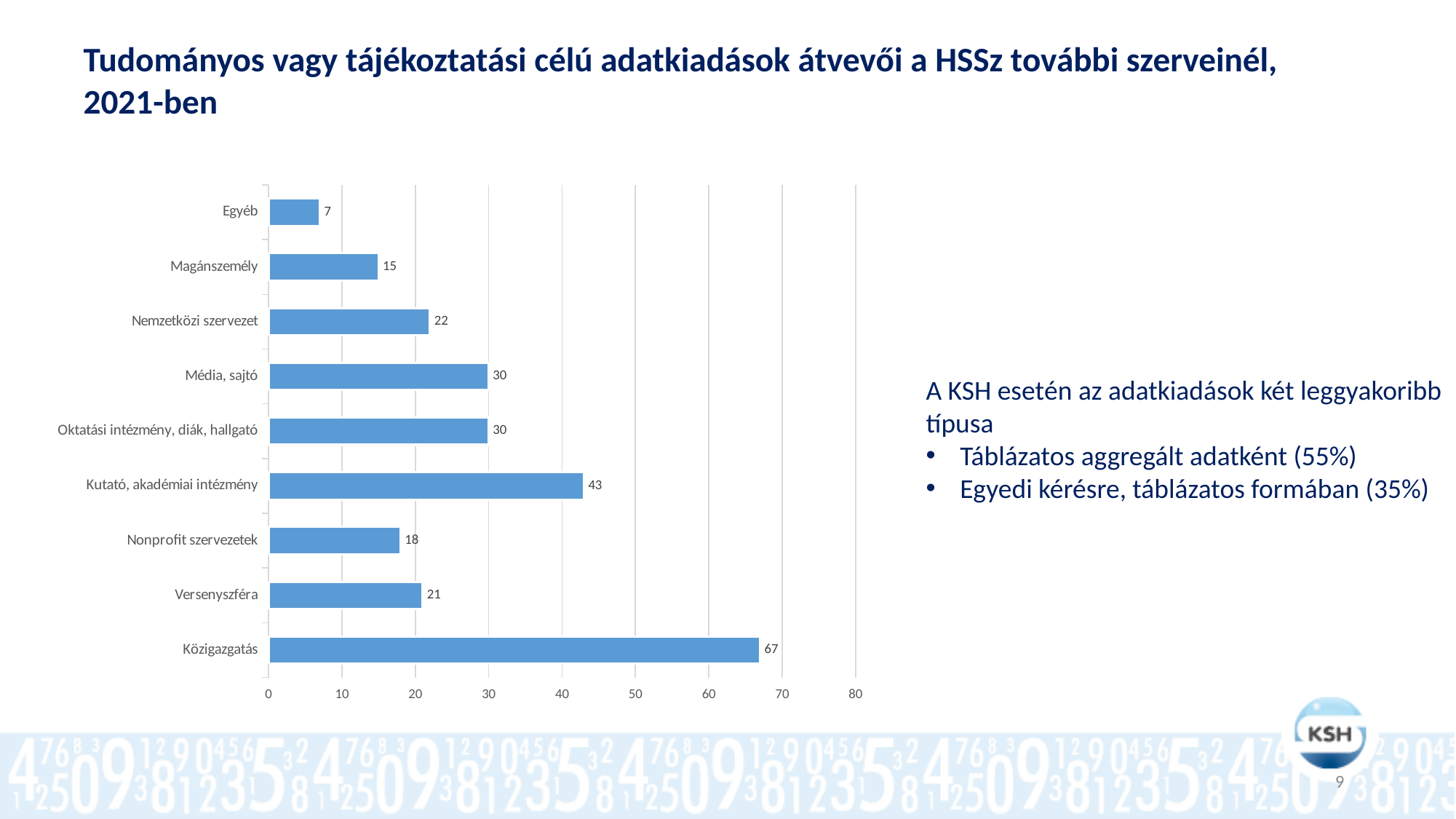
Which category has the lowest value? Egyéb What kind of chart is shown on the slide? bar chart Which is larger, the value for Versenyszféra or the value for Nonprofit szervezetek? Versenyszféra Which category has the highest value? Közigazgatás What is the value for Kutató, akadémiai intézmény? 43 What is the value for Magánszemély? 15 What is the difference between the values for Közigazgatás and Kutató, akadémiai intézmény? 24 How many categories are shown in the chart? 9 What is the value for Közigazgatás? 67 What is the highest value shown on the x axis? 80 What is the value for Média, sajtó? 30 Is the value for Nemzetközi szervezet greater or less than 30? less